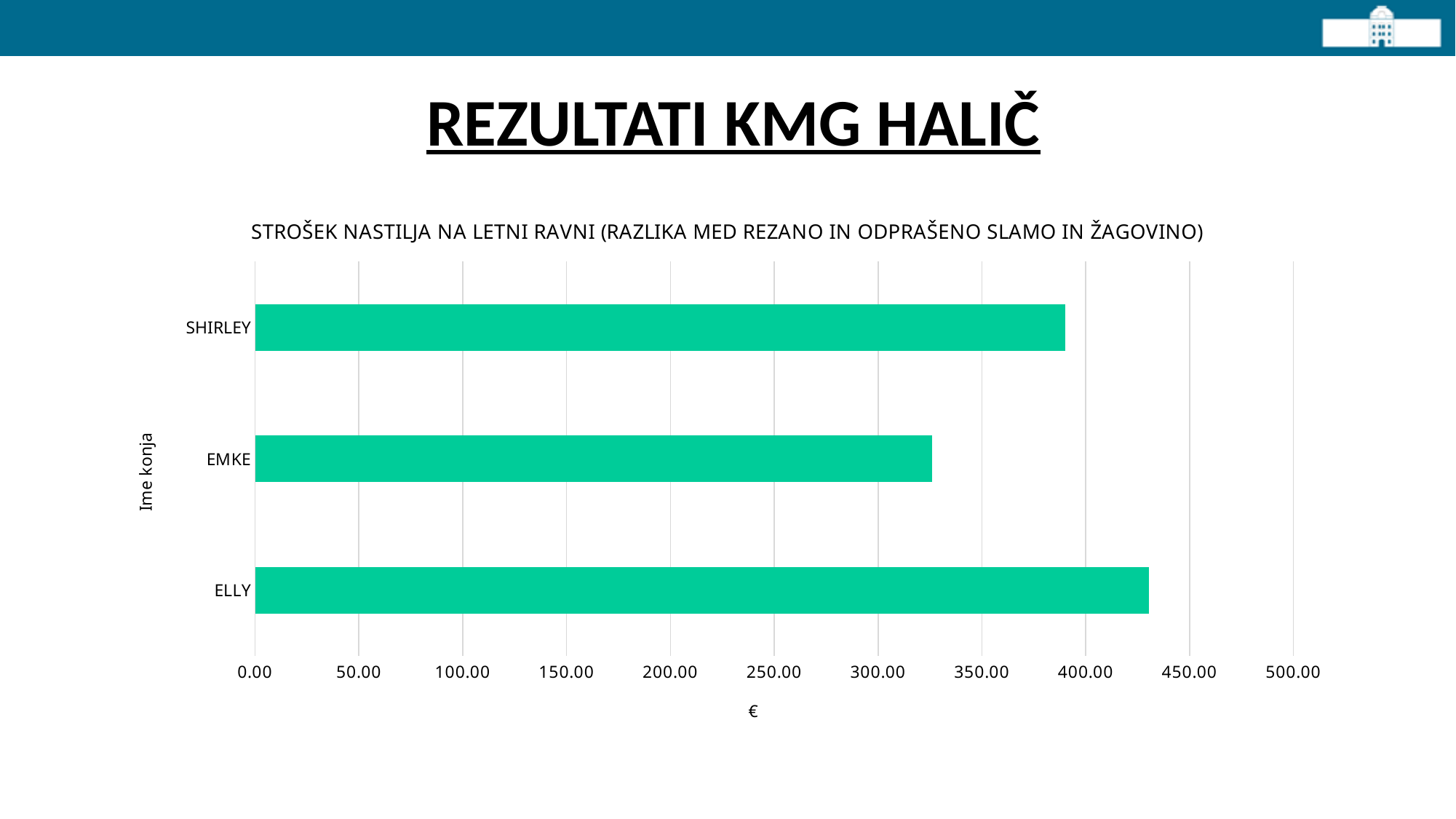
Is the value for SHIRLEY greater or less than 350.00? greater What kind of chart is shown on the slide? bar chart Which horse has the highest annual bedding cost in the chart? ELLY Which horse has the lowest annual bedding cost in the chart? EMKE What unit is shown as the horizontal axis label of the chart? € Is the value for ELLY greater or less than 400.00? greater Which has a larger value, ELLY or SHIRLEY? ELLY Is the value for EMKE greater or less than 350.00? less How many horses (categories) are shown in the chart? 3 What is the label of the vertical axis of the chart? Ime konja Which has a larger value, SHIRLEY or EMKE? SHIRLEY